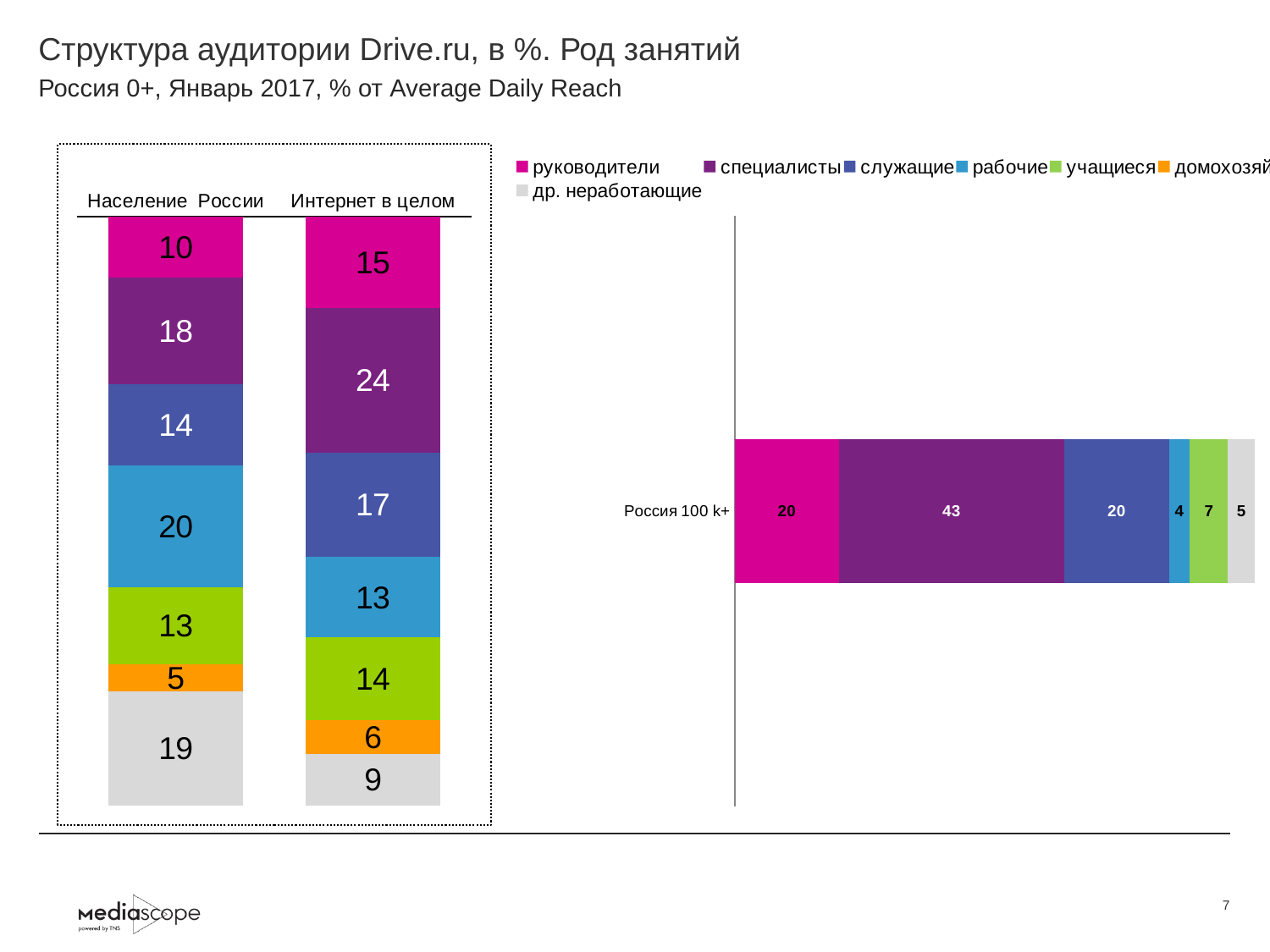
In the right chart (Россия 100 k+), what is the value of the учащиеся segment? 7 How many bars does the left stacked bar chart show? 2 In the right chart (Россия 100 k+), what is the value of the специалисты segment? 43 In the left stacked bar chart, what is the value of the рабочие segment for Население России? 20 In the left stacked bar chart, which segment is the largest in the Интернет в целом bar? специалисты In the left stacked bar chart, which segment is the smallest in the Население России bar? домохозяйки In the left stacked bar chart, what is the value of the др. неработающие segment for Население России? 19 In the left stacked bar chart, what is the difference between the руководители values for Интернет в целом and Население России? 5 How many series does the legend list? 7 What type of chart is the right chart (Россия 100 k+)? stacked bar chart In the left stacked bar chart, what is the value of the специалисты segment for Интернет в целом? 24 In the left stacked bar chart, which is larger: the служащие value for Население России or for Интернет в целом? Интернет в целом